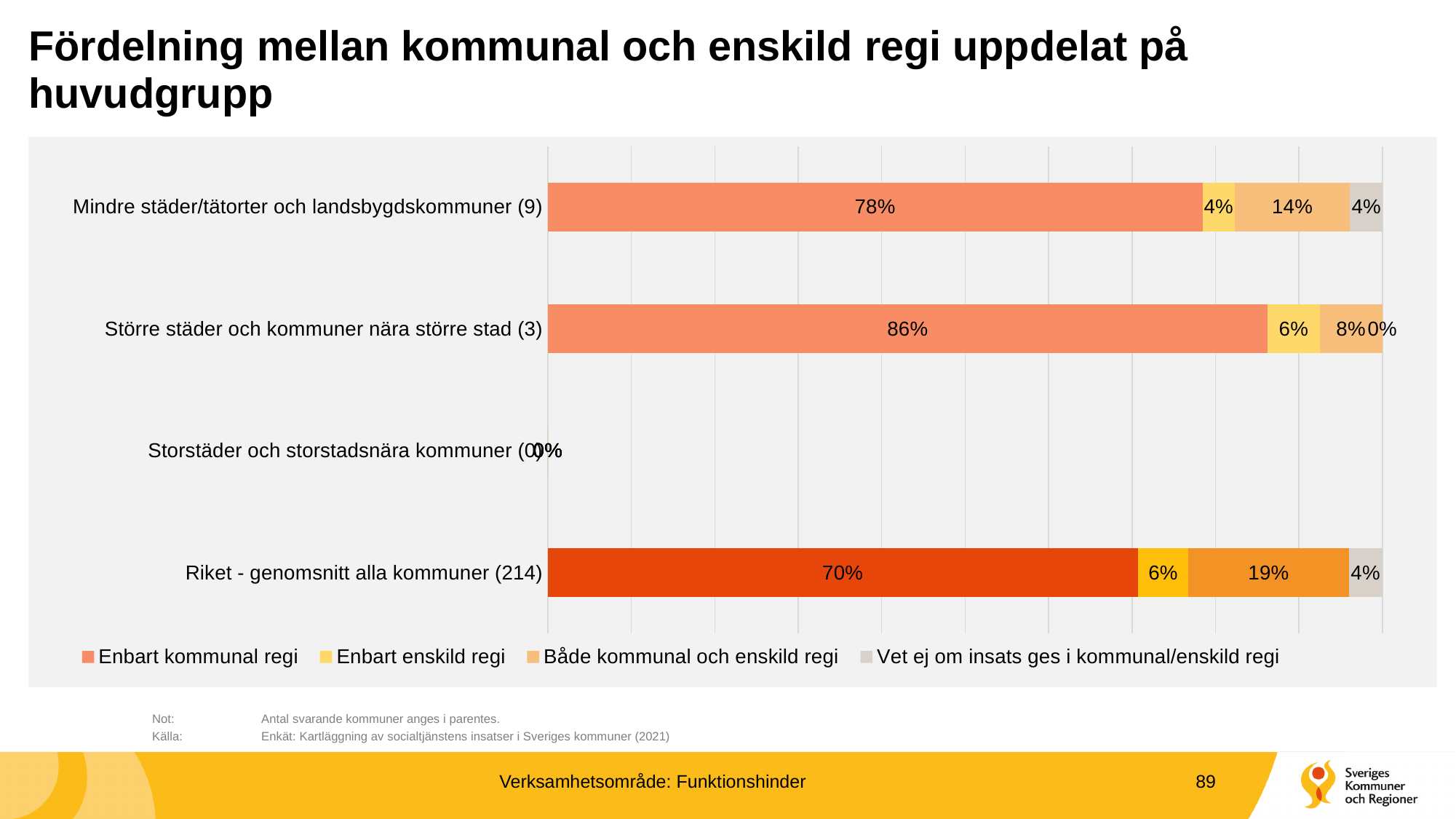
How many categories are shown on the y axis of the chart? 4 How many series does the legend list? 4 Which is larger: the "Både kommunal och enskild regi" value for "Riket - genomsnitt alla kommuner (214)" or for "Större städer och kommuner nära större stad (3)"? Riket - genomsnitt alla kommuner (214) What is the value for "Både kommunal och enskild regi" for "Mindre städer/tätorter och landsbygdskommuner (9)"? 14% What kind of chart is shown on the slide? Stacked bar chart What is the value for "Enbart enskild regi" for "Mindre städer/tätorter och landsbygdskommuner (9)"? 4% What is the difference between the "Enbart kommunal regi" values for "Större städer och kommuner nära större stad (3)" and "Riket - genomsnitt alla kommuner (214)"? 16 percentage points What is the value for "Enbart kommunal regi" for "Riket - genomsnitt alla kommuner (214)"? 70% What is the value for "Både kommunal och enskild regi" for "Riket - genomsnitt alla kommuner (214)"? 19% What is the last entry in the chart's legend? Vet ej om insats ges i kommunal/enskild regi What is the value for "Enbart kommunal regi" for "Större städer och kommuner nära större stad (3)"? 86% Which category has the highest value for "Enbart kommunal regi"? Större städer och kommuner nära större stad (3)